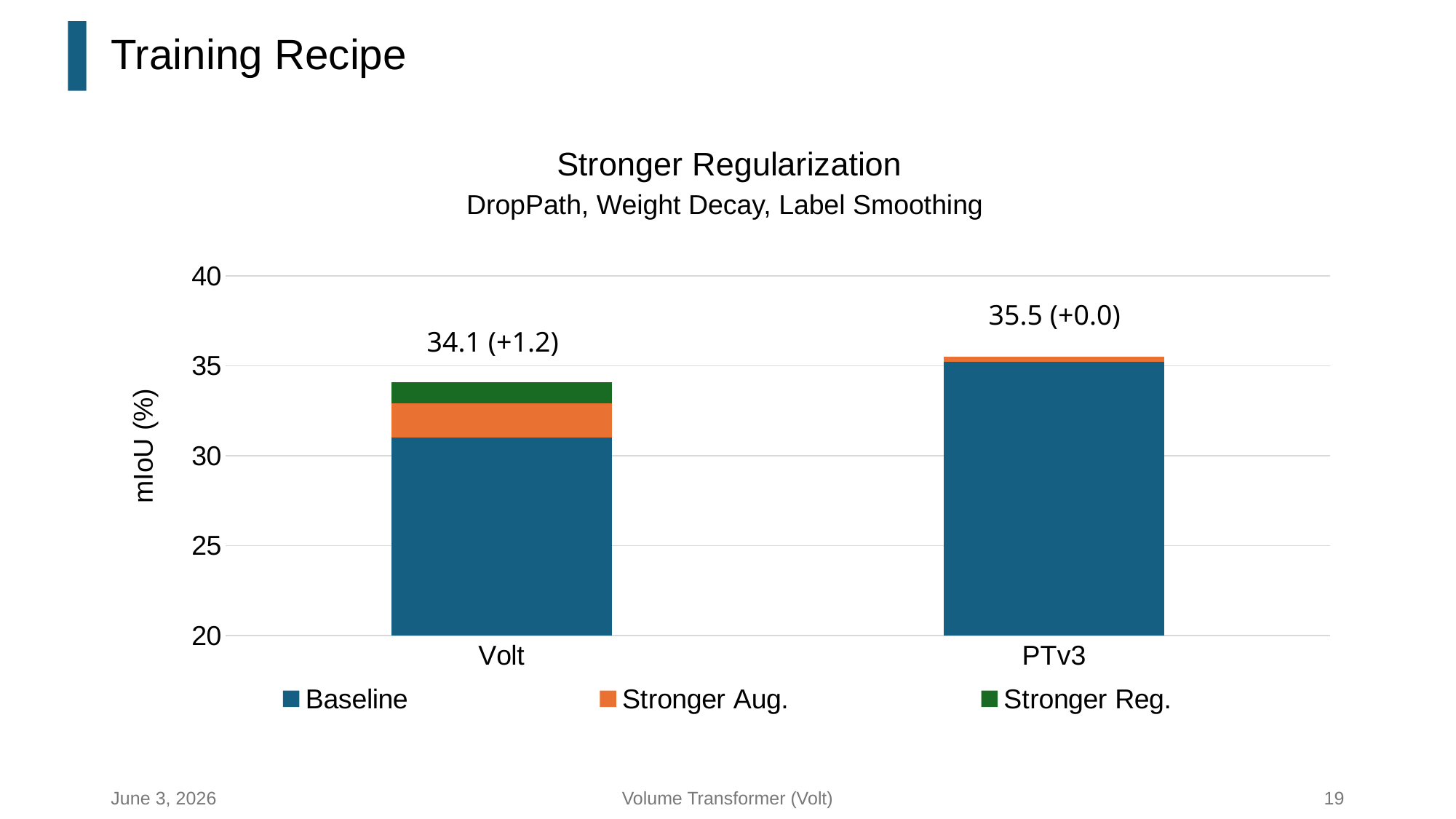
What is the title of the chart? Stronger Regularization What is the difference between the total mIoU of PTv3 and Volt? 1.4 What is the data label shown above the PTv3 bar? 35.5 (+0.0) How many categories are shown on the x axis of the chart? 2 What is the data label shown above the Volt bar? 34.1 (+1.2) Is the Baseline value for Volt greater or less than 35? less What kind of chart is shown on the slide? Stacked bar chart Which category has the higher total mIoU, Volt or PTv3? PTv3 How many series does the legend list? 3 What is the label of the y axis? mIoU (%) What is the total mIoU shown for Volt? 34.1 What is the total mIoU shown for PTv3? 35.5